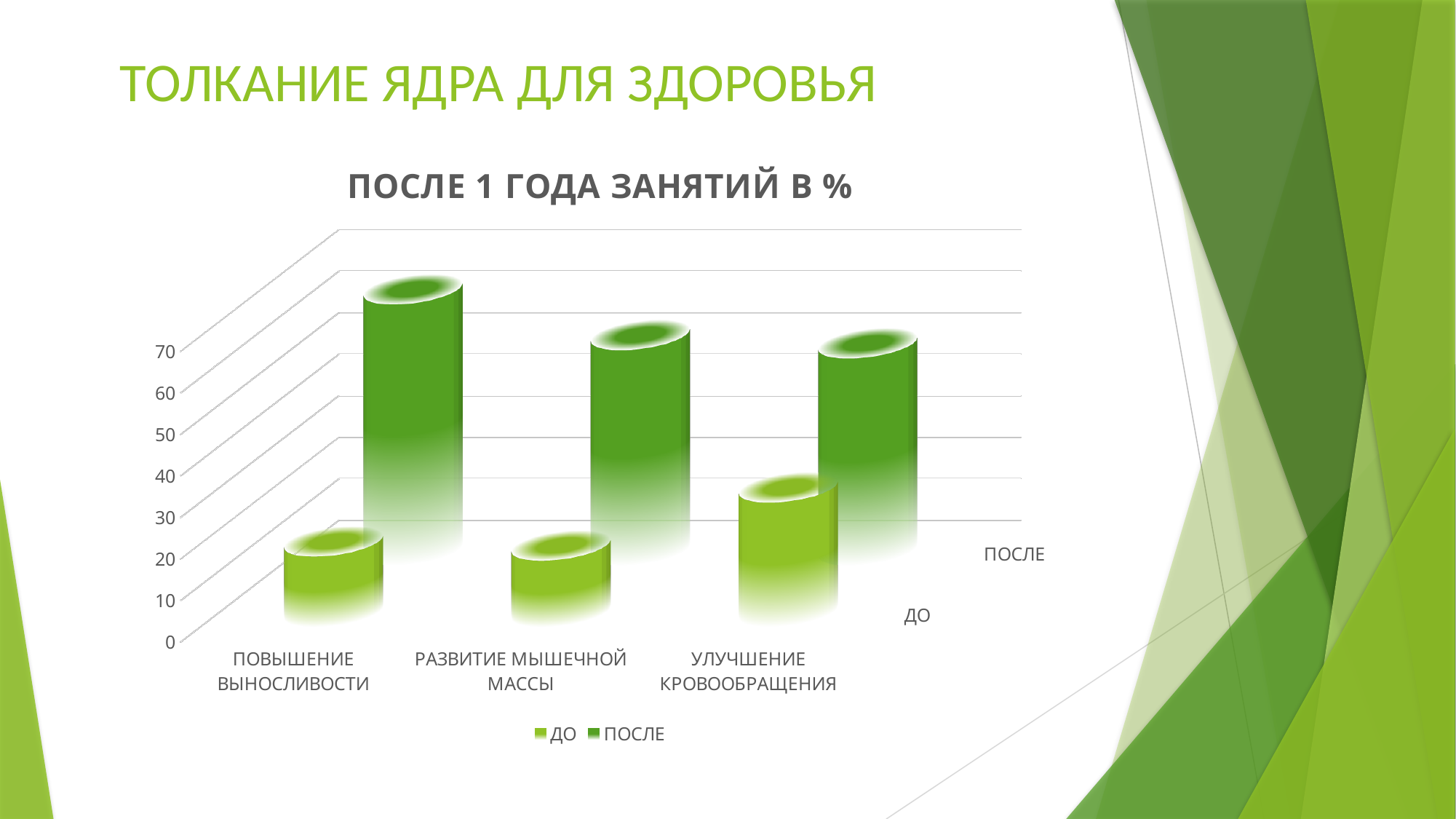
How many series does the chart legend list? 2 Is the ДО value for ПОВЫШЕНИЕ ВЫНОСЛИВОСТИ greater or less than 40? less Which category has the highest ПОСЛЕ value? ПОВЫШЕНИЕ ВЫНОСЛИВОСТИ Which category has the highest ДО value? УЛУЧШЕНИЕ КРОВООБРАЩЕНИЯ Is the ПОСЛЕ value for ПОВЫШЕНИЕ ВЫНОСЛИВОСТИ greater or less than 40? greater For ПОВЫШЕНИЕ ВЫНОСЛИВОСТИ, which is larger: the ДО value or the ПОСЛЕ value? ПОСЛЕ What are the two series named in the legend? ДО and ПОСЛЕ What type of chart is shown on the slide? Bar chart How many categories are shown on the x axis of the chart? 3 What is the title of the chart? ПОСЛЕ 1 ГОДА ЗАНЯТИЙ В % For УЛУЧШЕНИЕ КРОВООБРАЩЕНИЯ, which is larger: the ДО value or the ПОСЛЕ value? ПОСЛЕ